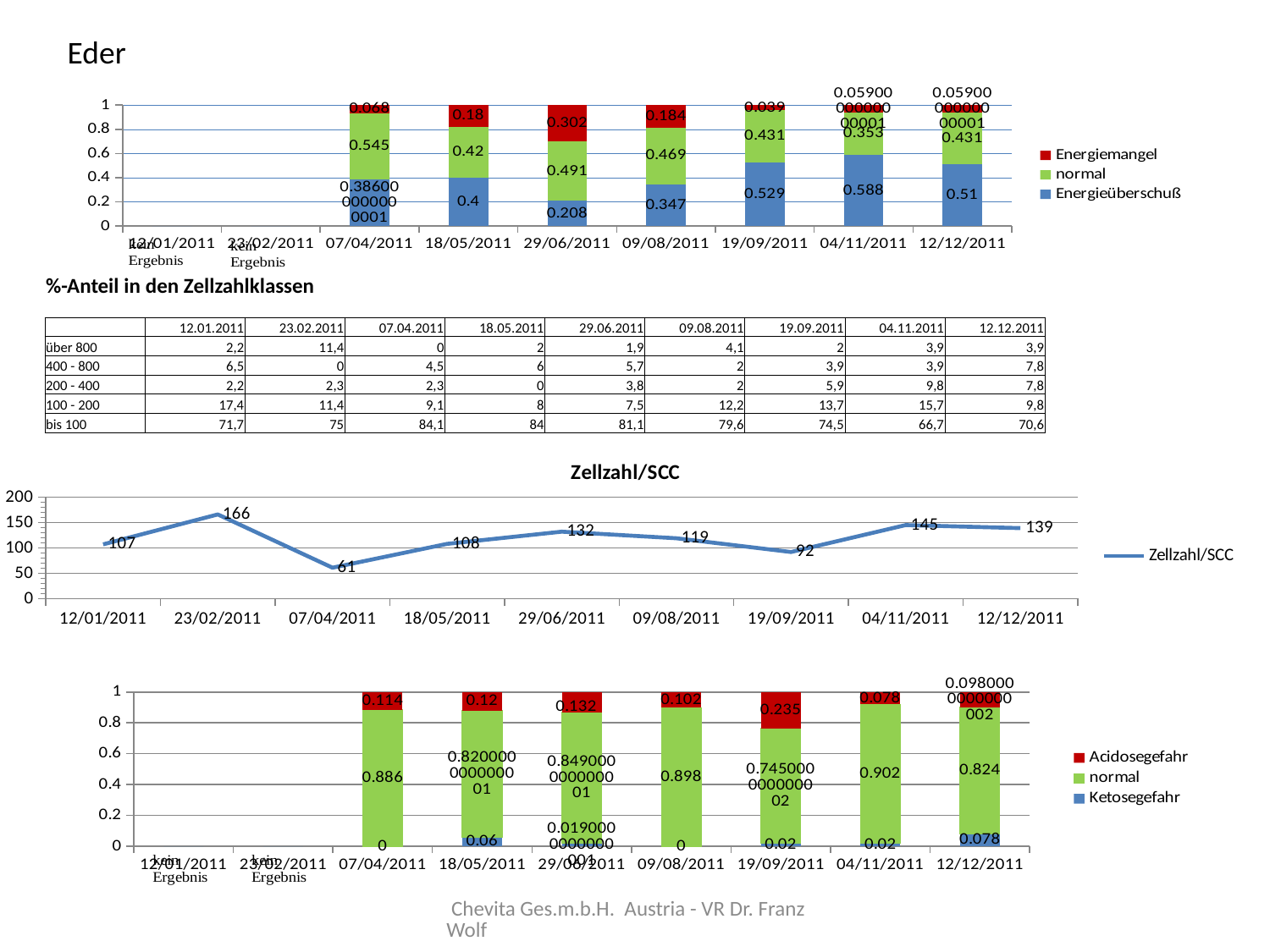
In the Zellzahl/SCC chart, which date has the highest value? 23/02/2011 In the top stacked bar chart, what is the Energieüberschuß value for 04/11/2011? 0.588 How many series does the legend of the top stacked bar chart list? 3 In the Zellzahl/SCC chart, which date has the lowest value? 07/04/2011 In the Zellzahl/SCC chart, what is the value for 23/02/2011? 166 In the top stacked bar chart, what is the normal value for 29/06/2011? 0.491 In the bottom stacked bar chart, which date has the larger Acidosegefahr value, 07/04/2011 or 19/09/2011? 19/09/2011 In the Zellzahl/SCC chart, what is the difference between the values for 04/11/2011 and 12/12/2011? 6 In the bottom stacked bar chart, what is the normal value for 04/11/2011? 0.902 In the Zellzahl/SCC chart, do the values rise or fall from 07/04/2011 to 29/06/2011? rise In the bottom stacked bar chart, what is the Acidosegefahr value for 19/09/2011? 0.235 What kind of chart is the Zellzahl/SCC chart? line chart